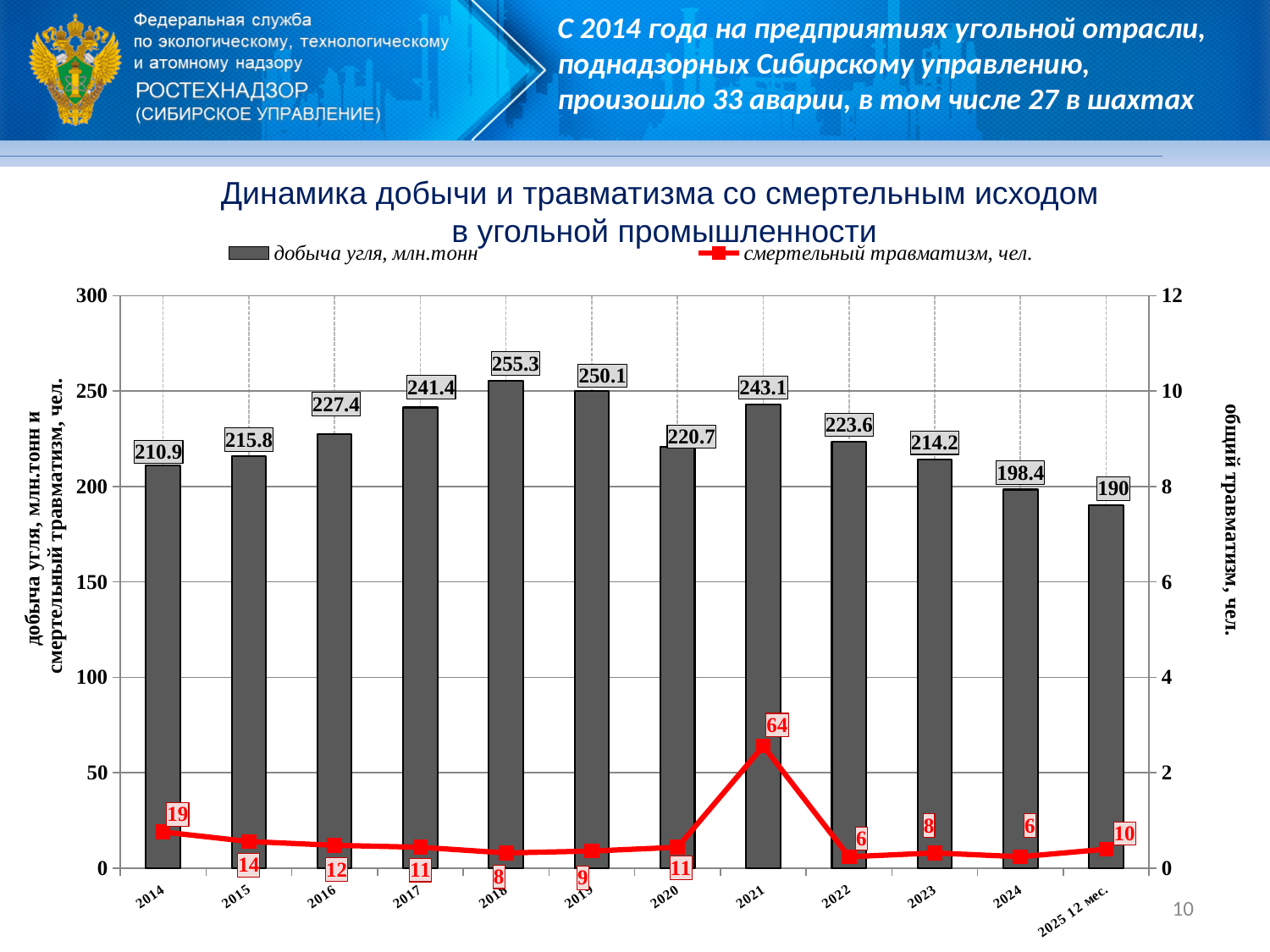
Did coal production rise or fall from 2021 to 2025 12 мес.? fall What is the coal production value shown for 2025 12 мес.? 190 How many series does the legend list? 2 What was coal production (добыча угля, млн.тонн) in 2018? 255.3 How many fatal injuries (смертельный травматизм, чел.) were recorded in 2021? 64 Which year has the lowest number of fatal injuries? 2022 and 2024 (6) Which year had higher coal production, 2017 or 2021? 2021 What kind of chart is used to show coal production? bar chart Is the coal production value for 2024 greater or less than 200? less How many years (categories) are shown on the x axis? 12 Which year has the highest coal production? 2018 What is the difference in coal production between 2018 and 2025 12 мес.? 65.3